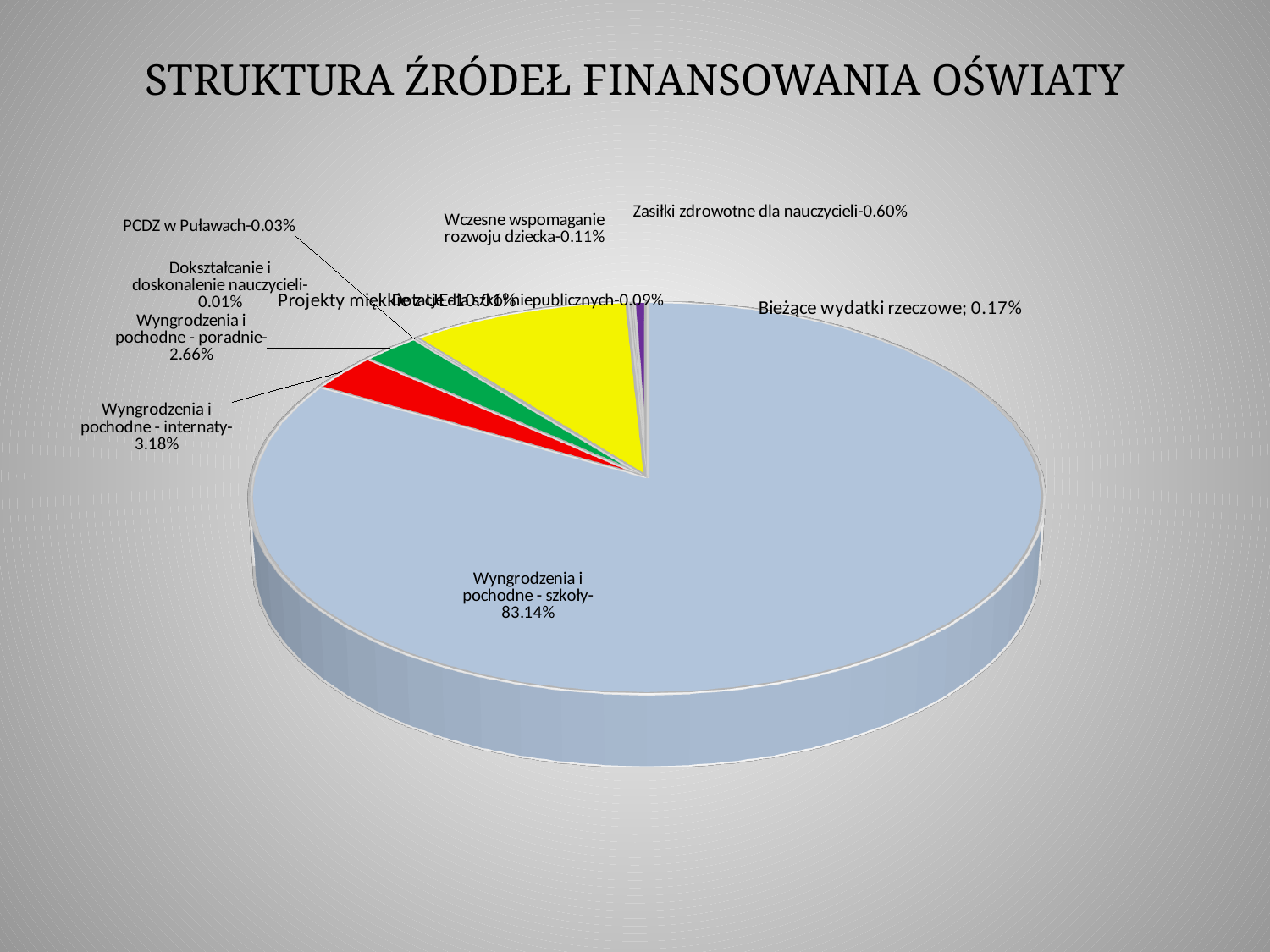
What percentage is labelled for "PCDZ w Puławach"? 0.03% What share of the pie does "Wyngrodzenia i pochodne - szkoły" represent? 83.14% Which labelled category has the smallest share of the pie? Dokształcanie i doskonalenie nauczycieli Which is larger: the share for "Wyngrodzenia i pochodne - internaty" or for "Wyngrodzenia i pochodne - poradnie"? Wyngrodzenia i pochodne - internaty What is the difference between the shares for "Wyngrodzenia i pochodne - internaty" and "Wyngrodzenia i pochodne - poradnie"? 0.52% Which category has the largest share of the pie? Wyngrodzenia i pochodne - szkoły What type of chart is shown on the slide? Pie chart What is the value shown for "Wyngrodzenia i pochodne - poradnie"? 2.66% What percentage is labelled for "Wczesne wspomaganie rozwoju dziecka"? 0.11% What value is shown for "Bieżące wydatki rzeczowe"? 0.17% What is the value shown for "Wyngrodzenia i pochodne - internaty"? 3.18% What percentage is labelled for "Zasiłki zdrowotne dla nauczycieli"? 0.60%